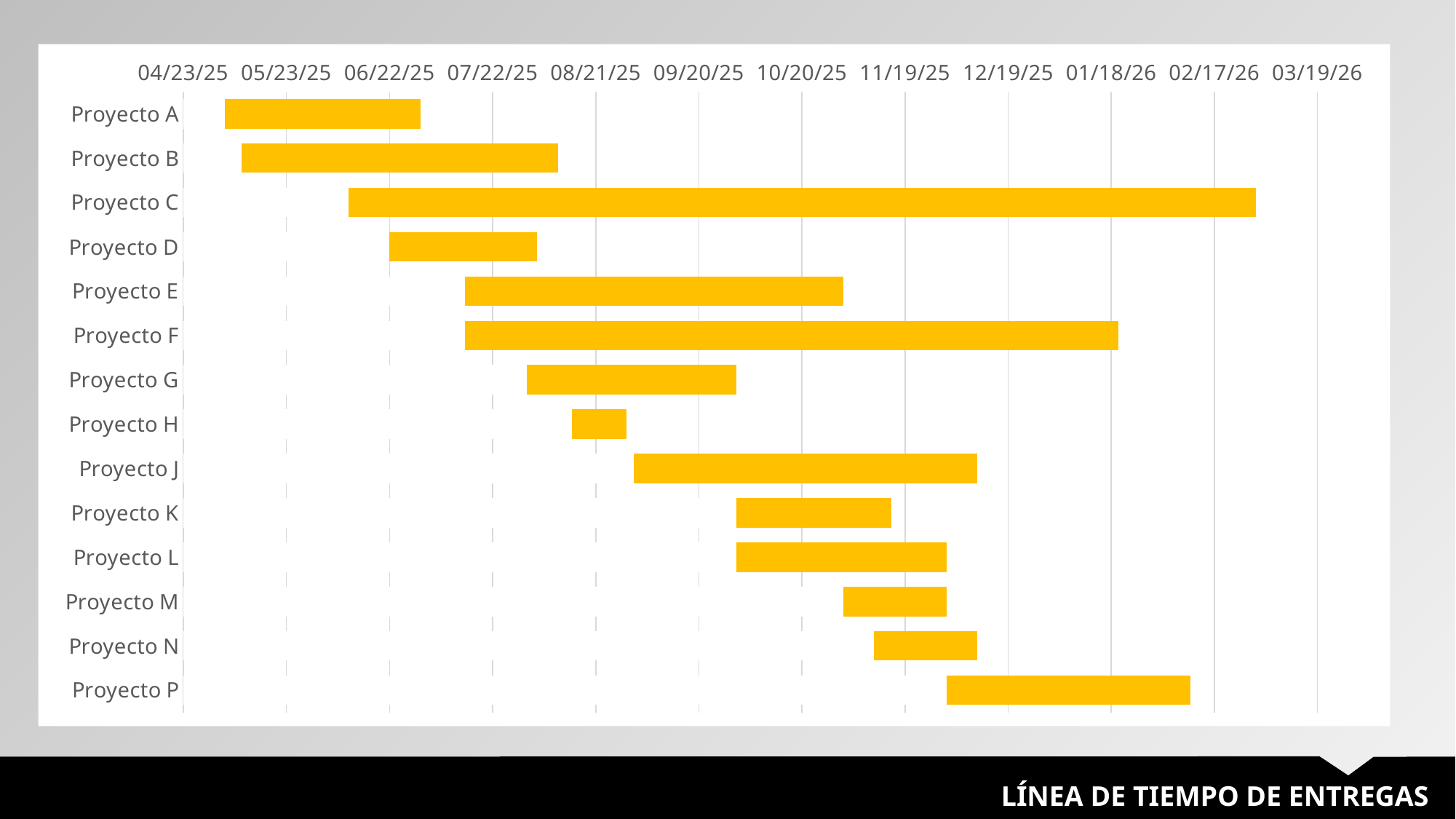
What is the title shown at the bottom of the slide? LÍNEA DE TIEMPO DE ENTREGAS Which project has a longer duration, Proyecto E or Proyecto F? Proyecto F Which project ends last on the timeline? Proyecto C Is the start date of Proyecto H earlier or later than 08/21/25? earlier Which project has the shortest bar (shortest duration)? Proyecto H Which project has the longest bar (longest duration)? Proyecto C Is the start date of Proyecto A earlier or later than 05/23/25? earlier Which project starts first on the timeline? Proyecto A How many projects are listed on the chart? 14 Is the end date of Proyecto P earlier or later than 01/18/26? later What kind of chart is shown on the slide? Bar chart (Gantt chart) Which project has a longer duration, Proyecto B or Proyecto D? Proyecto B